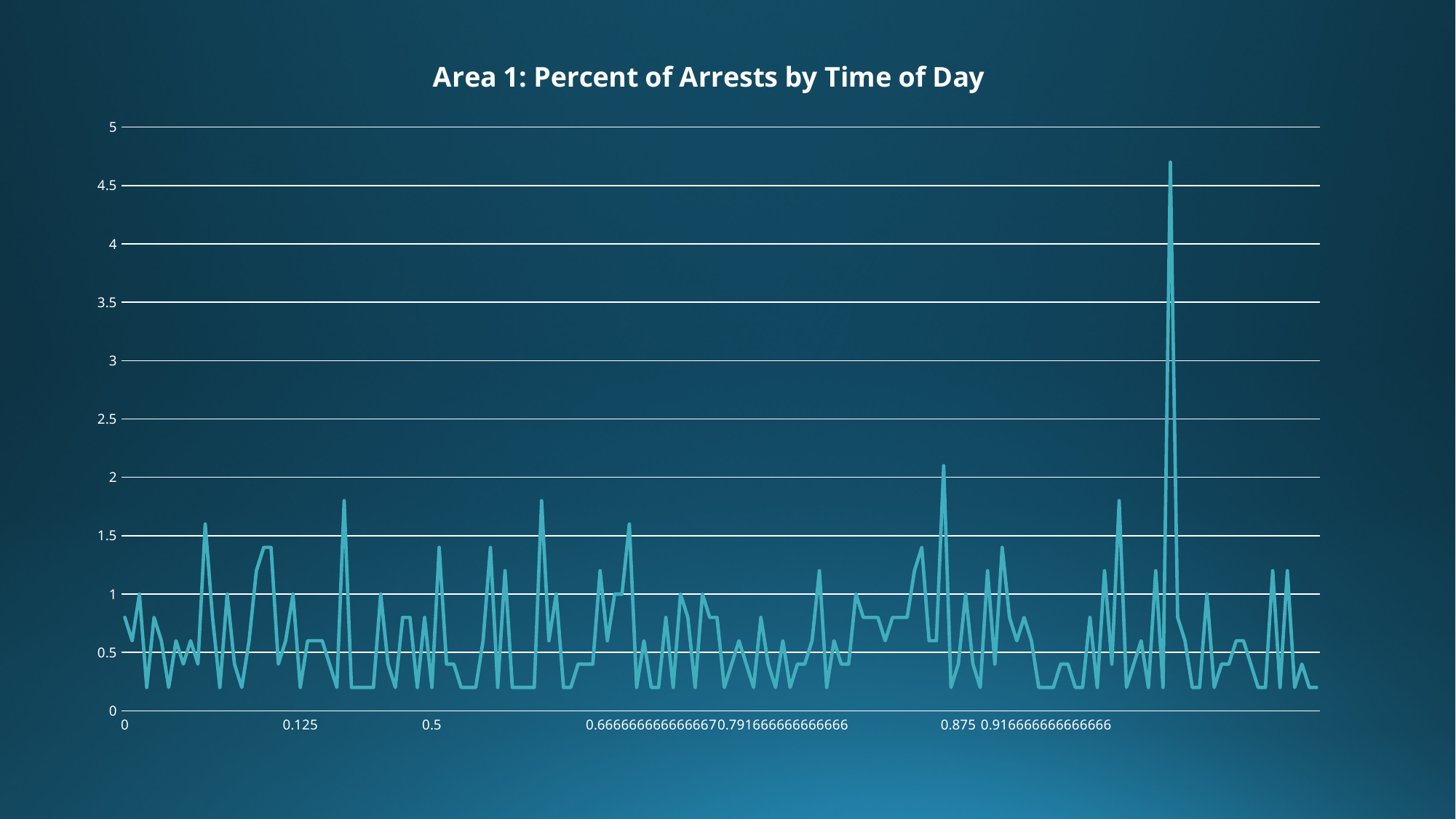
Is the value at x = 0 greater or less than 0.5? greater Is the highest peak of the line greater or less than 5? less Is the highest peak of the line greater or less than 4.5? greater What is the title of the chart? Area 1: Percent of Arrests by Time of Day How many lines (data series) are plotted on the chart? 1 What is the highest value shown on the vertical axis? 5 What kind of chart is shown on the slide? line chart